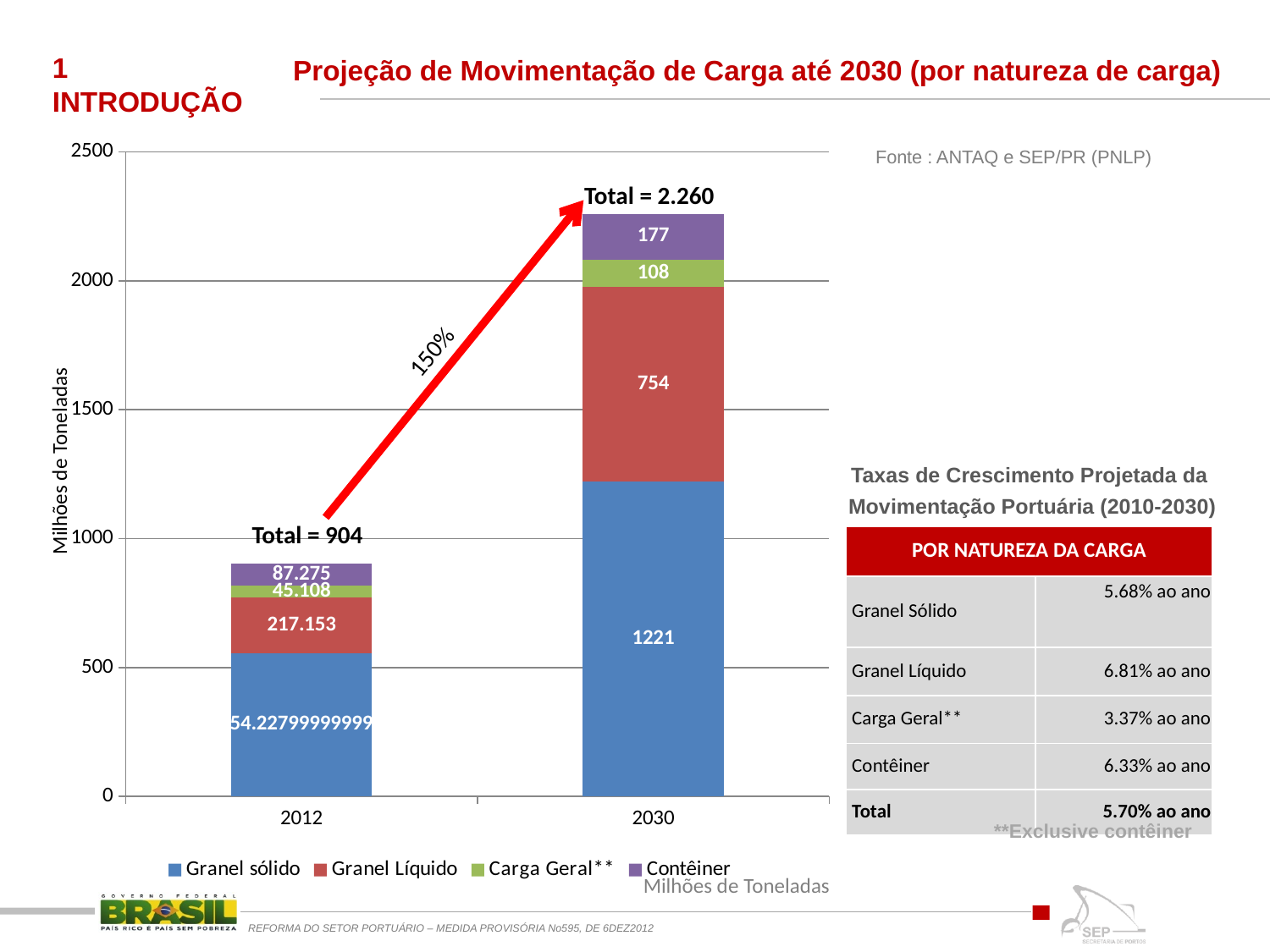
What is the total of the stacked bar for 2030? 2.260 Is the value for Granel sólido in 2012 greater or less than 500? greater What is the value for Granel Líquido in 2030? 754 What is the total of the stacked bar for 2012? 904 What kind of chart is shown? Stacked bar chart What is the value for Carga Geral** in 2030? 108 What is the value for Contêiner in 2012? 87.275 What is the difference between the Granel Líquido values for 2030 and 2012? 536.847 What is the value for Granel sólido in 2030? 1221 How many series does the legend list? 4 What is the label on the vertical axis of the chart? Milhões de Toneladas Which is larger in 2030, Granel Líquido or Contêiner? Granel Líquido